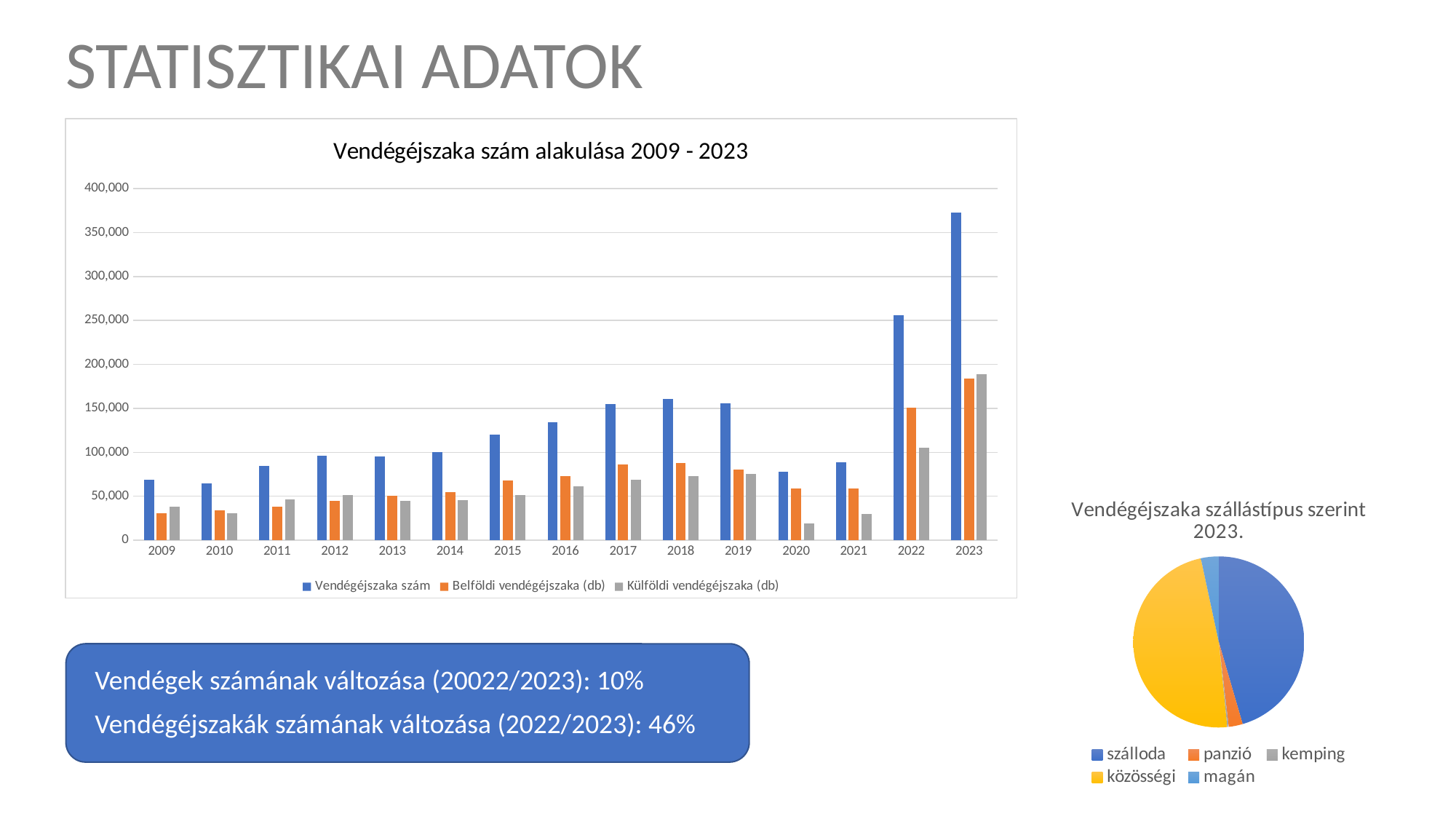
In the chart 'Vendégéjszaka szám alakulása 2009 - 2023', which is larger in 2022: Belföldi vendégéjszaka (db) or Külföldi vendégéjszaka (db)? Belföldi vendégéjszaka (db) In the chart 'Vendégéjszaka szám alakulása 2009 - 2023', is the value for Belföldi vendégéjszaka (db) in 2023 greater or less than 200,000? less In the chart 'Vendégéjszaka szám alakulása 2009 - 2023', is the value for Vendégéjszaka szám in 2022 greater or less than 200,000? greater In the chart 'Vendégéjszaka szám alakulása 2009 - 2023', how many years are shown on the x axis? 15 In the chart 'Vendégéjszaka szám alakulása 2009 - 2023', does Vendégéjszaka szám generally rise or fall from 2009 to 2019? rise In the chart 'Vendégéjszaka szám alakulása 2009 - 2023', how many series does the legend list? 3 In the chart 'Vendégéjszaka szám alakulása 2009 - 2023', is the value for Vendégéjszaka szám larger in 2019 or in 2020? 2019 In the chart 'Vendégéjszaka szám alakulása 2009 - 2023', which year has the lowest value for Külföldi vendégéjszaka (db)? 2020 What kind of chart is the chart titled 'Vendégéjszaka szám alakulása 2009 - 2023'? bar chart What kind of chart is the chart titled 'Vendégéjszaka szállástípus szerint 2023.'? pie chart In the chart 'Vendégéjszaka szám alakulása 2009 - 2023', is the value for Vendégéjszaka szám in 2023 greater or less than 350,000? greater In the chart 'Vendégéjszaka szám alakulása 2009 - 2023', which year has the highest value for Vendégéjszaka szám? 2023